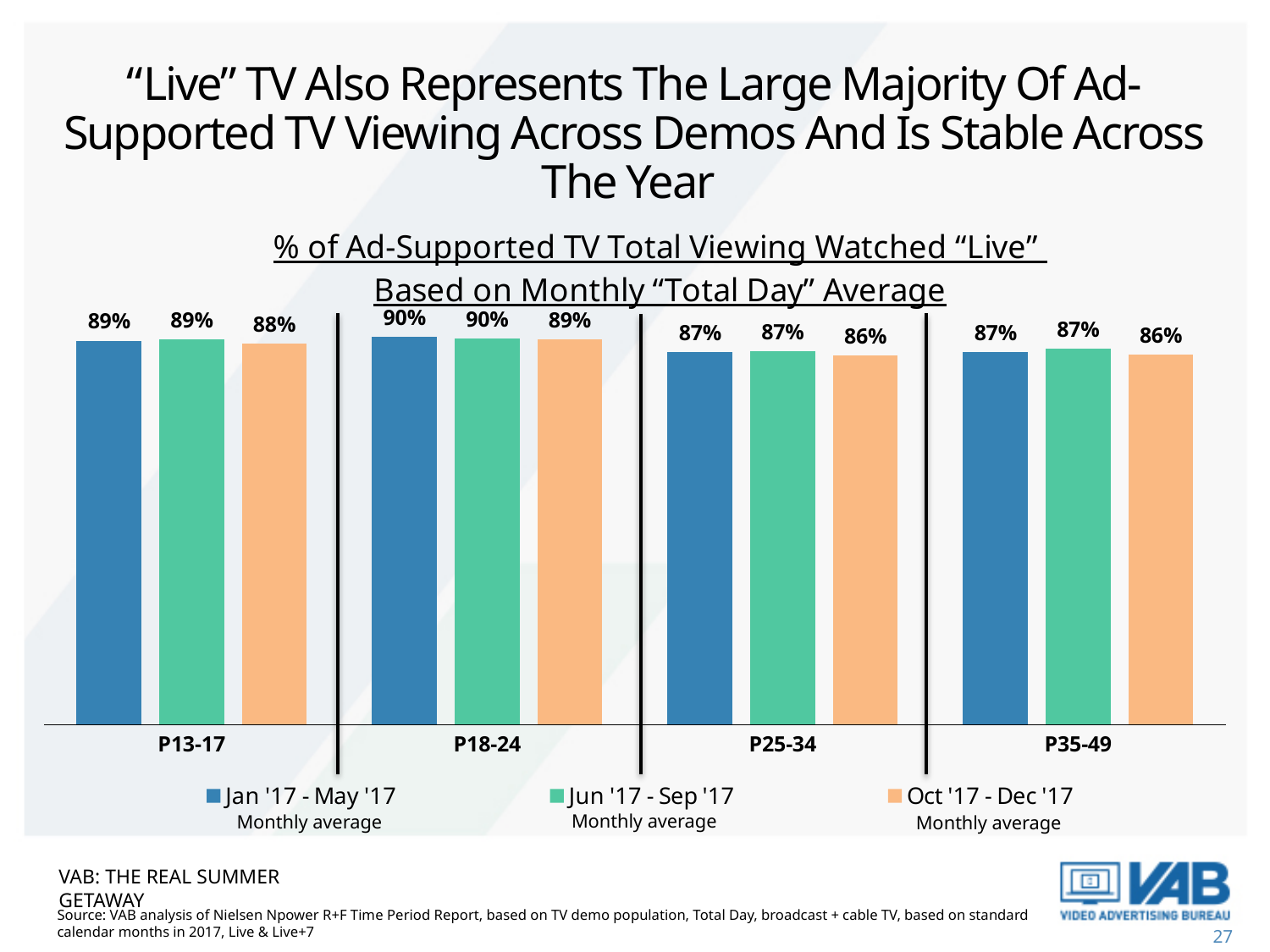
What kind of chart is shown on the slide? Bar chart How many demo categories are shown on the x axis? 4 How many series does the legend list? 3 Which series is shown in orange according to the legend? Oct '17 - Dec '17 Which demo has the highest value in the Oct '17 - Dec '17 series? P18-24 What is the value for P35-49 in the Jan '17 - May '17 series? 87% What is the value for P18-24 in the Jan '17 - May '17 series? 90% What is the difference between the Jan '17 - May '17 value for P18-24 and the Oct '17 - Dec '17 value for P25-34? 4% What is the value for P25-34 in the Oct '17 - Dec '17 series? 86% Which is larger: the Jun '17 - Sep '17 value for P13-17 or the Jun '17 - Sep '17 value for P35-49? P13-17 What is the value for P13-17 in the Jun '17 - Sep '17 series? 89% Which demo has the highest value in the Jan '17 - May '17 series? P18-24